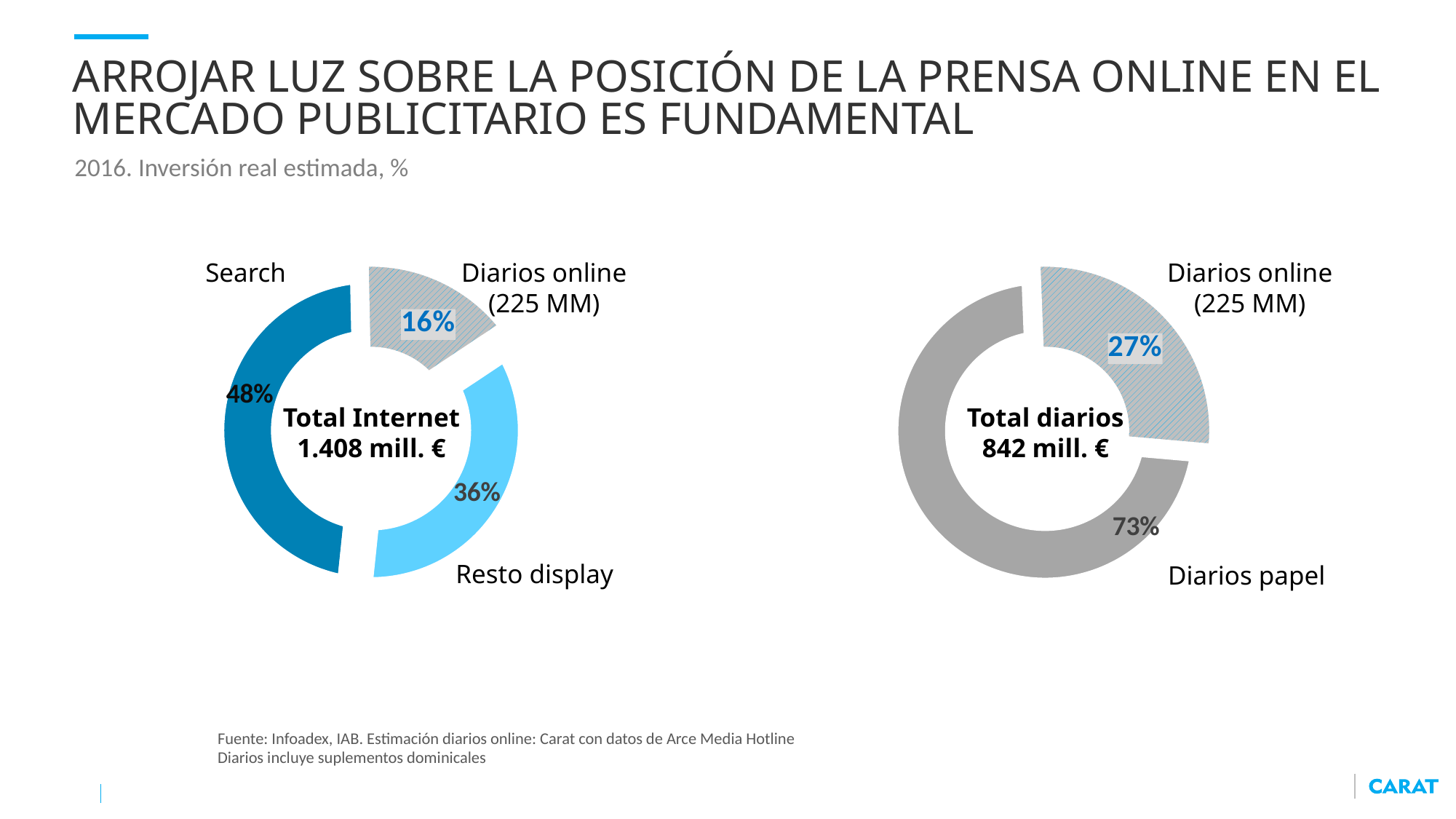
In the Total diarios chart on the right, what is the difference in percentage points between Diarios papel and Diarios online? 46 In the Total Internet chart on the left, what is the difference in percentage points between Search and Resto display? 12 In the Total diarios chart on the right, what share do Diarios papel have? 73% How many categories does the Total Internet chart on the left show? 3 In the Total Internet chart on the left, what share does Resto display have? 36% Which is larger: the share of Diarios online in the Total Internet chart or in the Total diarios chart? Total diarios chart In the Total diarios chart on the right, what share do Diarios online have? 27% In the Total Internet chart on the left, what share do Diarios online have? 16% In the Total Internet chart on the left, what share does Search have? 48% What kind of chart is the Total diarios chart on the right? Doughnut (pie) chart In the Total Internet chart on the left, which category has the smallest share? Diarios online In the Total Internet chart on the left, which category has the largest share? Search